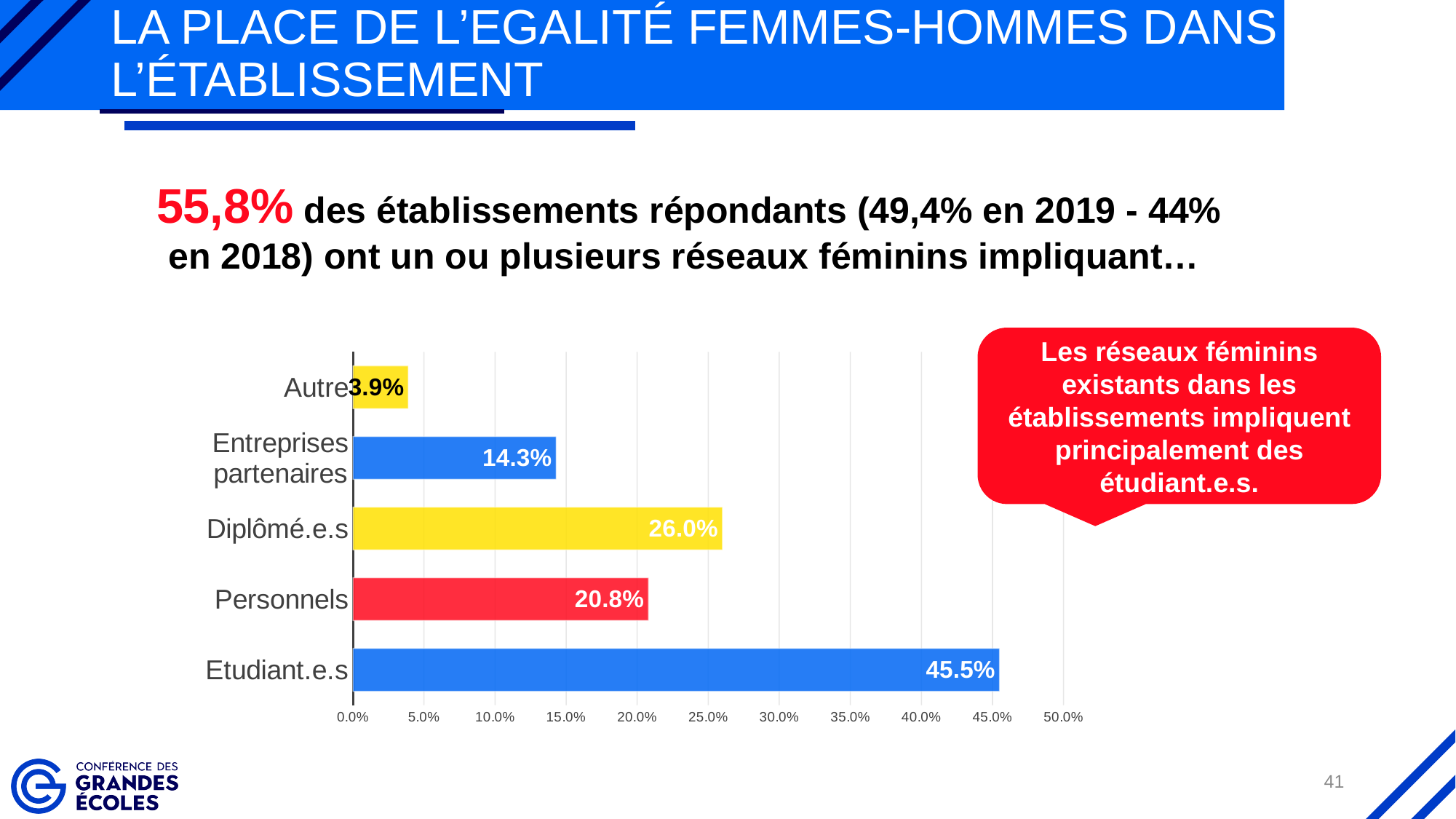
Is the value for Diplômé.e.s greater or less than 25.0%? greater Which is larger, the value for Personnels or the value for Entreprises partenaires? Personnels What is the value for Etudiant.e.s? 45.5% What is the value for Autre? 3.9% Which category has the highest value? Etudiant.e.s Which category has the lowest value? Autre How many categories are shown in the chart? 5 What is the difference between the values for Etudiant.e.s and Diplômé.e.s? 19.5% What is the value for Diplômé.e.s? 26.0% What kind of chart is shown on the slide? Bar chart What is the value for Personnels? 20.8% What is the value for Entreprises partenaires? 14.3%